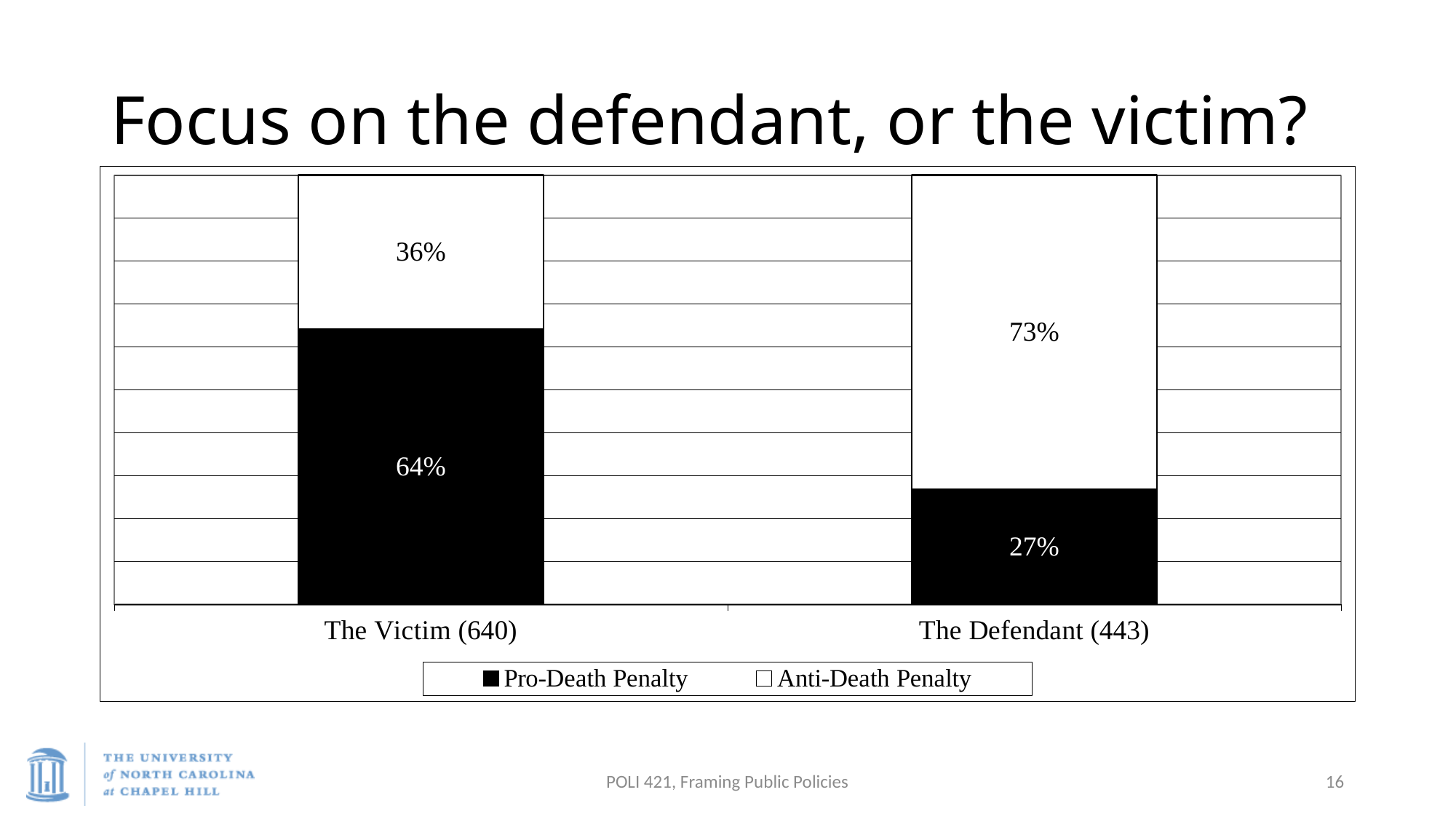
Which is larger: the Anti-Death Penalty value for The Defendant (443) or the Anti-Death Penalty value for The Victim (640)? The Defendant (443) What is the difference between the Pro-Death Penalty values for The Victim (640) and The Defendant (443)? 37% Which category has the lowest Anti-Death Penalty value? The Victim (640) How many series does the legend list? 2 How many categories are shown on the x axis? 2 What kind of chart is shown on the slide? Stacked bar chart What is the Pro-Death Penalty value for The Defendant (443)? 27% What is the Pro-Death Penalty value for The Victim (640)? 64% What is the Anti-Death Penalty value for The Defendant (443)? 73% Which series is shown in black in the legend? Pro-Death Penalty What is the Anti-Death Penalty value for The Victim (640)? 36% Which category has the highest Pro-Death Penalty value? The Victim (640)